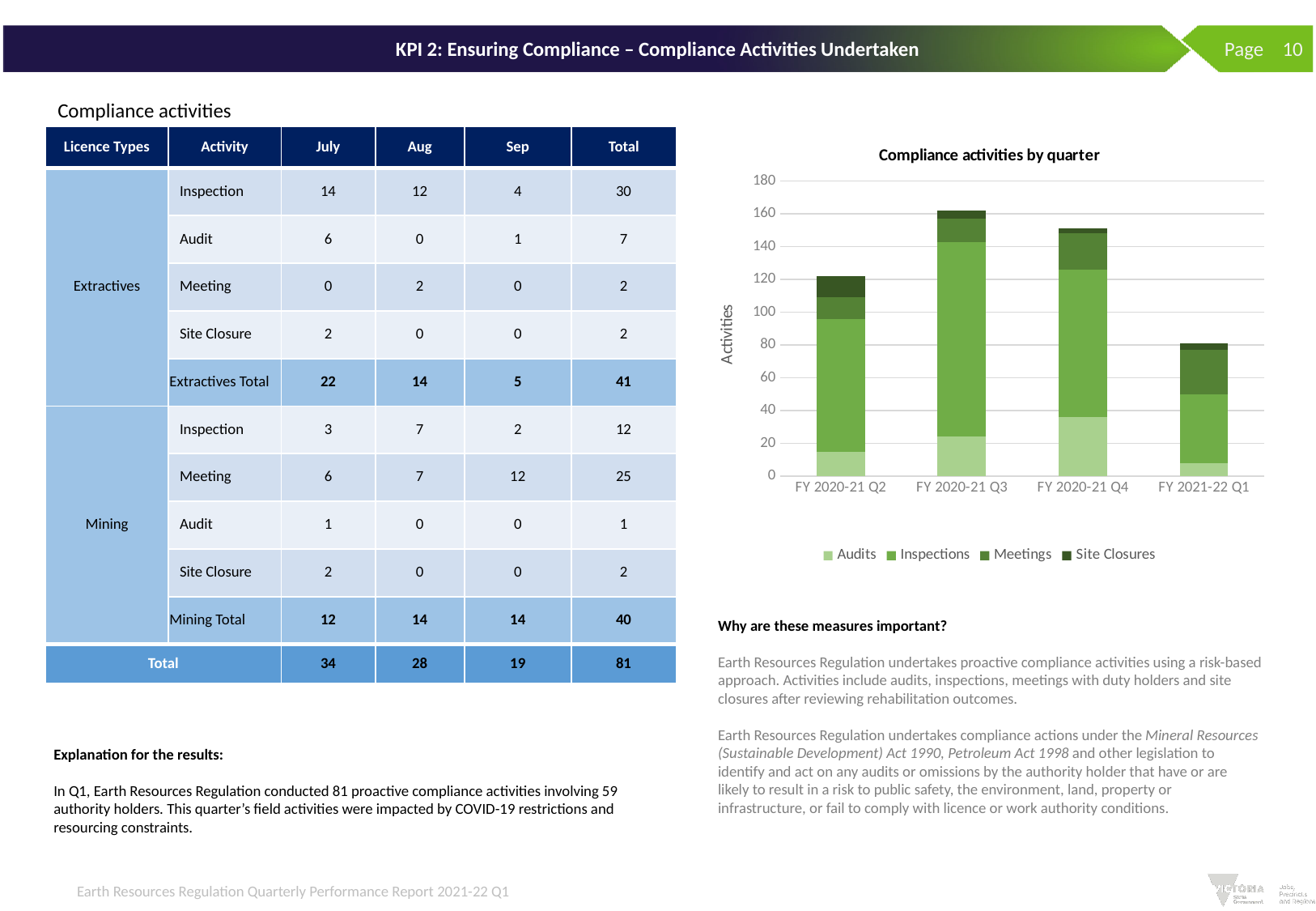
How many series does the legend of the 'Compliance activities by quarter' chart list? 4 In the 'Compliance activities by quarter' chart, is the total bar height for FY 2021-22 Q1 greater or less than 100? less Which quarter has the tallest bar in the 'Compliance activities by quarter' chart? FY 2020-21 Q3 How many quarters are shown on the x axis of the 'Compliance activities by quarter' chart? 4 In the 'Compliance activities by quarter' chart, does the total bar height rise or fall from FY 2020-21 Q4 to FY 2021-22 Q1? fall Which quarter has the shortest bar in the 'Compliance activities by quarter' chart? FY 2021-22 Q1 In the 'Compliance activities by quarter' chart, is the total bar height for FY 2020-21 Q2 greater or less than 140? less What type of chart is 'Compliance activities by quarter'? Stacked bar chart In the 'Compliance activities by quarter' chart, is the total bar height for FY 2020-21 Q3 greater or less than 140? greater What is the y-axis label of the 'Compliance activities by quarter' chart? Activities In the 'Compliance activities by quarter' chart, which bar is taller: FY 2020-21 Q2 or FY 2021-22 Q1? FY 2020-21 Q2 What are the legend entries in the 'Compliance activities by quarter' chart? Audits, Inspections, Meetings, Site Closures